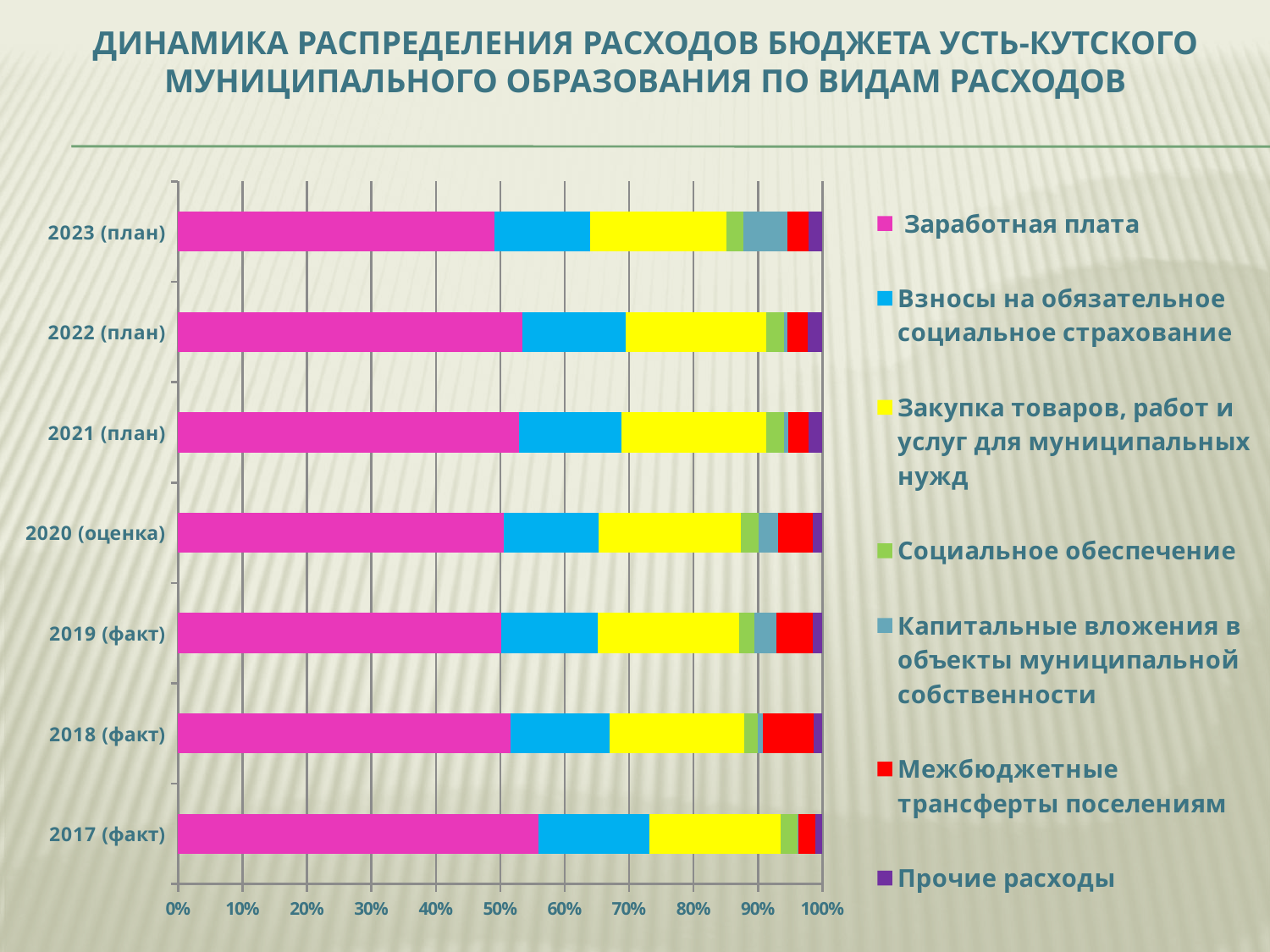
How many series does the legend list? 7 What is the maximum value shown on the horizontal axis? 100% Is the share of Заработная плата for 2022 (план) greater or less than 50%? greater Which is larger: the share of Заработная плата in 2017 (факт) or in 2023 (план)? 2017 (факт) Which year has the largest share of Межбюджетные трансферты поселениям? 2018 (факт) Is the share of Заработная плата for 2017 (факт) greater or less than 50%? greater Which year has the largest share of Заработная плата? 2017 (факт) What kind of chart is shown on the slide? stacked bar chart How many budget years (categories) are shown on the chart? 7 Which series is shown in magenta (pink) on the chart? Заработная плата Is the share of Заработная плата for 2018 (факт) greater or less than 60%? less